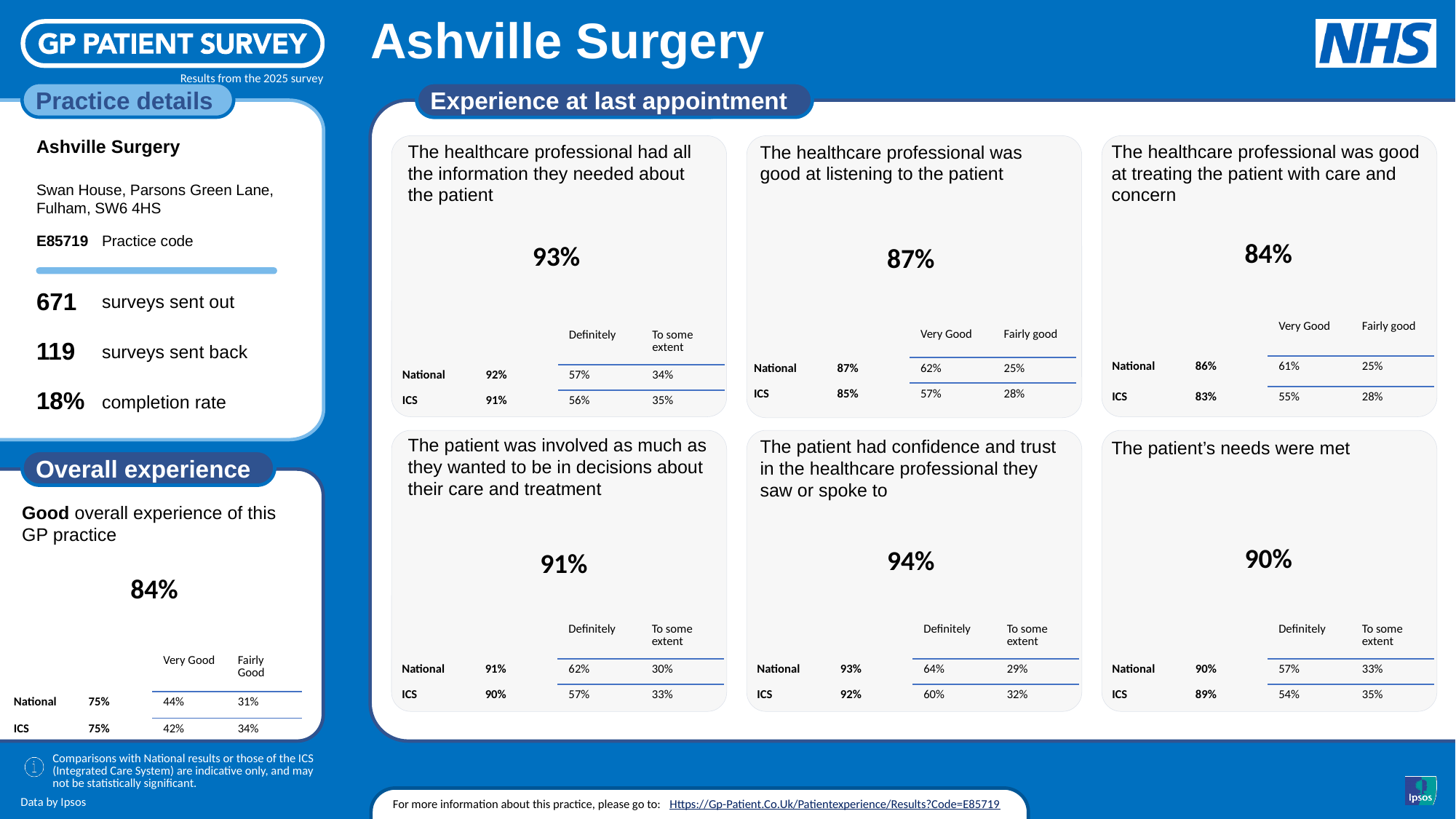
In the 'Overall experience' panel, what is the difference between the practice's 84% and the National 75%? 9 percentage points In the panel 'The patient's needs were met', is the practice's headline percentage larger than the ICS figure? Yes, 90% vs 89% In the panel 'The patient was involved as much as they wanted to be in decisions about their care and treatment', what is the National 'To some extent' percentage? 30% In the 'Overall experience' panel, what is the National figure for good overall experience? 75% In the panel 'The healthcare professional had all the information they needed about the patient', what is the practice's headline percentage? 93% In the 'Overall experience' panel, what percentage of patients reported a good overall experience of this GP practice? 84% How many question panels are shown under the 'Experience at last appointment' heading? 6 Which of the six 'Experience at last appointment' panels shows the lowest practice headline percentage? The healthcare professional was good at treating the patient with care and concern (84%) Which of the six 'Experience at last appointment' panels shows the highest practice headline percentage? The patient had confidence and trust in the healthcare professional they saw or spoke to (94%) In the panel 'The healthcare professional was good at listening to the patient', what is the ICS 'Very Good' percentage? 57% In the 'Overall experience' panel, what is the ICS 'Very Good' percentage? 42% In the panel 'The healthcare professional was good at treating the patient with care and concern', what is the National figure? 86%